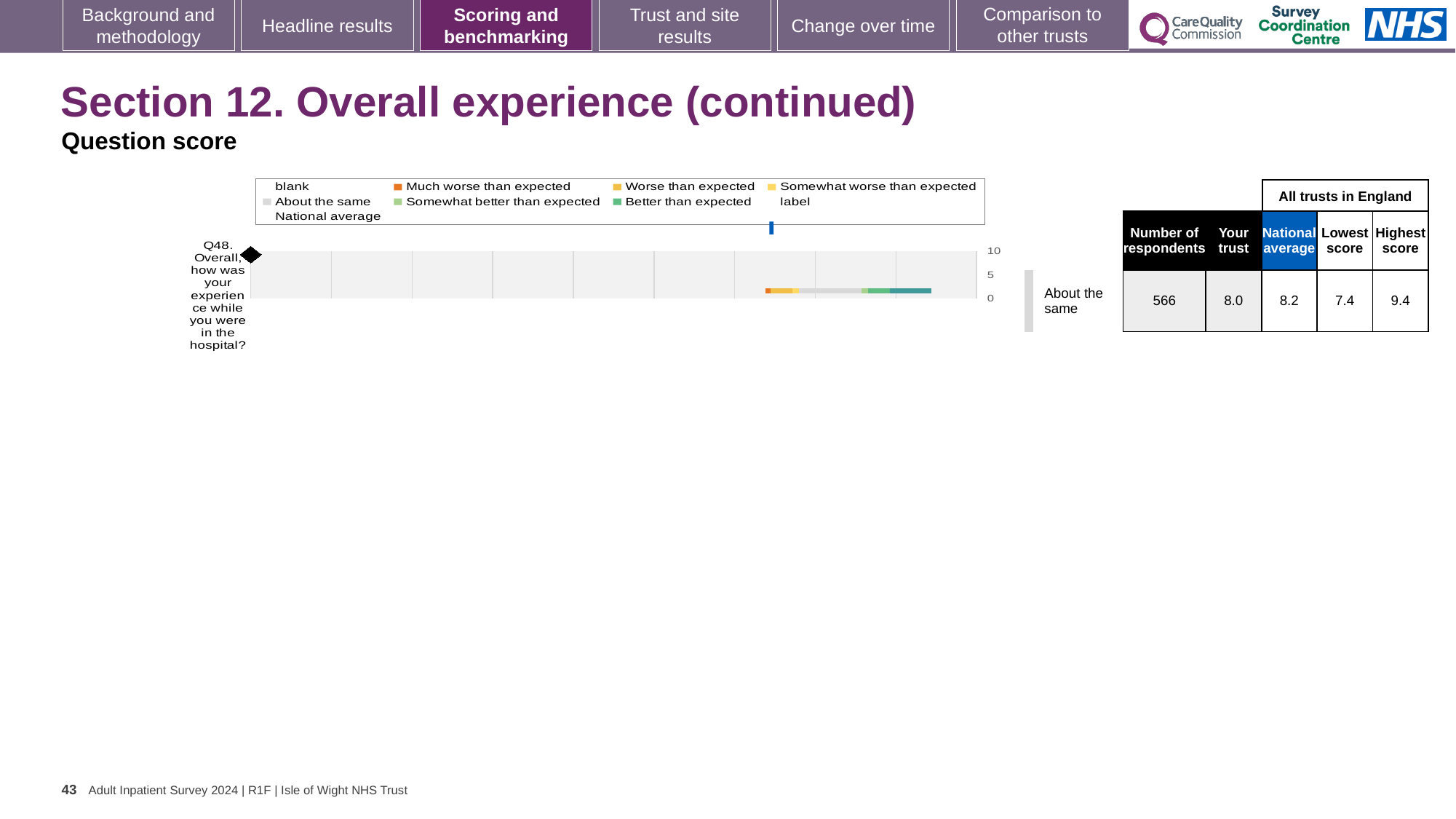
Which survey question is plotted on the chart? Q48. Overall, how was your experience while you were in the hospital? Which is larger for Q48, the 'Your trust' score or the national average? National average What is the lowest score among all trusts in England for Q48? 7.4 How many respondents answered Q48? 566 What is the difference between the highest score and the lowest score for Q48? 2.0 What is the national average score for Q48? 8.2 What benchmark category is shown for Q48? About the same What type of chart is used to show the Q48 question score? bar chart How many questions are plotted on the chart? 1 What is the 'Your trust' score for Q48? 8.0 Is the 'Your trust' score for Q48 greater or less than 5? greater What is the highest score among all trusts in England for Q48? 9.4